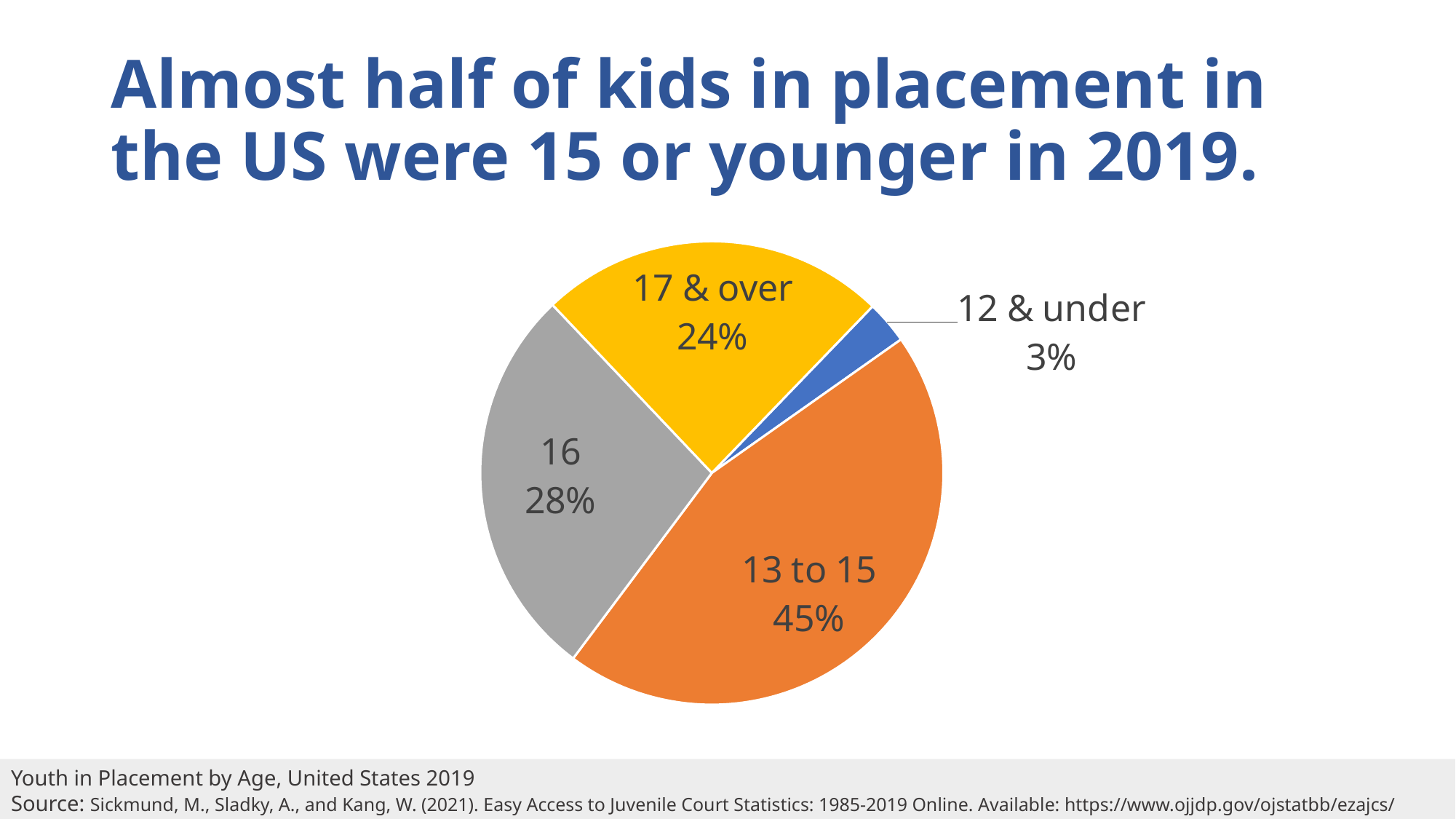
Which age group has the smallest slice of the pie? 12 & under What share of youth in placement were aged 16? 28% How many age groups are shown in the pie chart? 4 Which slice is larger, 16 or 17 & over? 16 What share of youth in placement were aged 17 & over? 24% What share of youth in placement were aged 13 to 15? 45% What is the combined share of the 12 & under and 13 to 15 slices? 48% What is the difference in percentage points between the 13 to 15 slice and the 16 slice? 17 What kind of chart is shown on the slide? pie chart What colour is the 13 to 15 slice? orange Which age group has the largest slice of the pie? 13 to 15